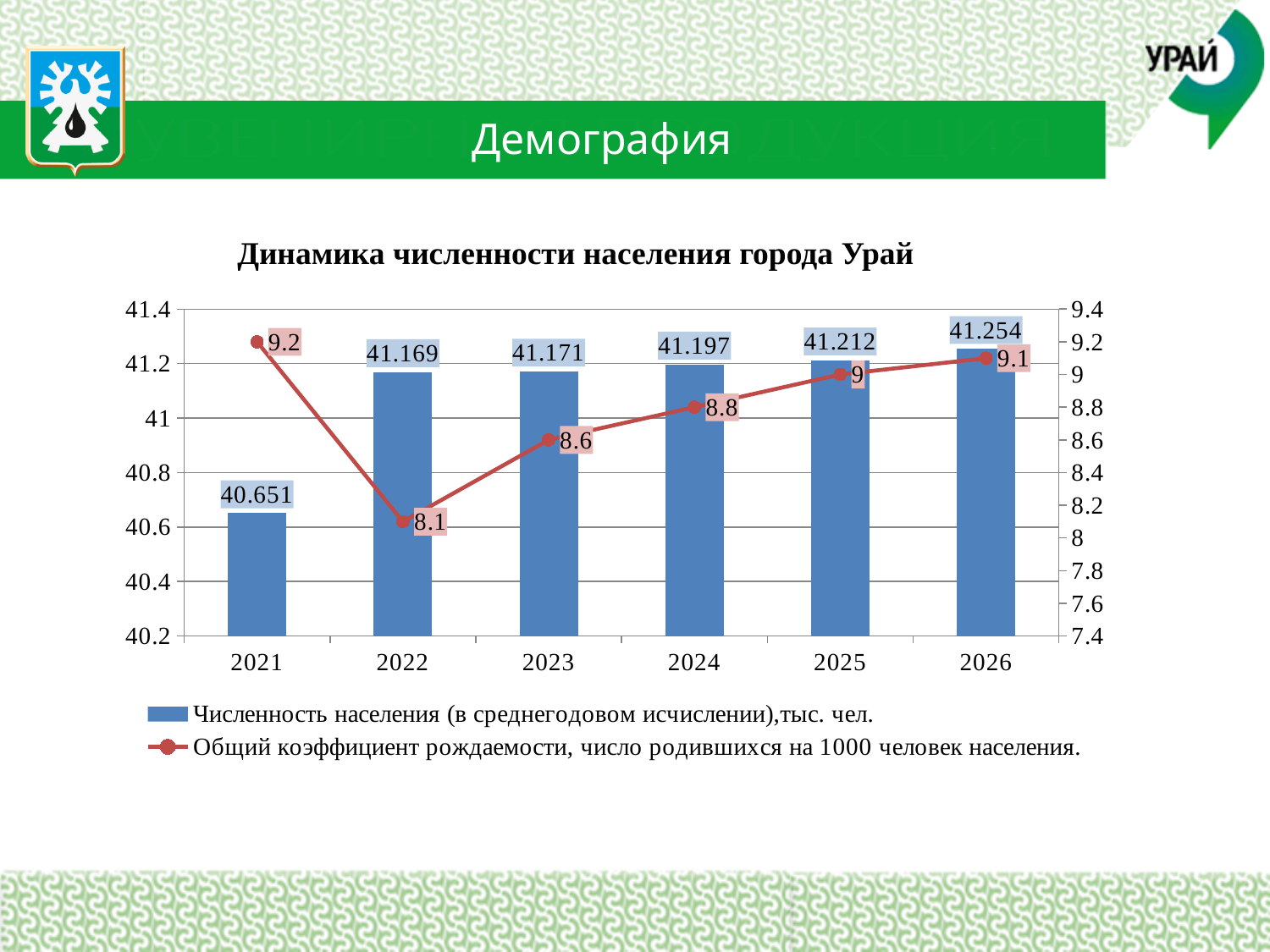
Which year has the lowest birth rate value? 2022 Is the birth rate higher in 2025 or in 2023? 2025 Which year has the lowest population value? 2021 What is the title of the chart? Динамика численности населения города Урай How many series does the legend list? 2 What is the population value (Численность населения) shown for 2021? 40.651 Does the population value rise or fall from 2021 to 2026? rise What is the birth rate (Общий коэффициент рождаемости) shown for 2022? 8.1 Which year has the highest birth rate value? 2021 How many years are shown on the x axis? 6 What is the population value shown for 2026? 41.254 What is the difference between the population values for 2026 and 2021? 0.603